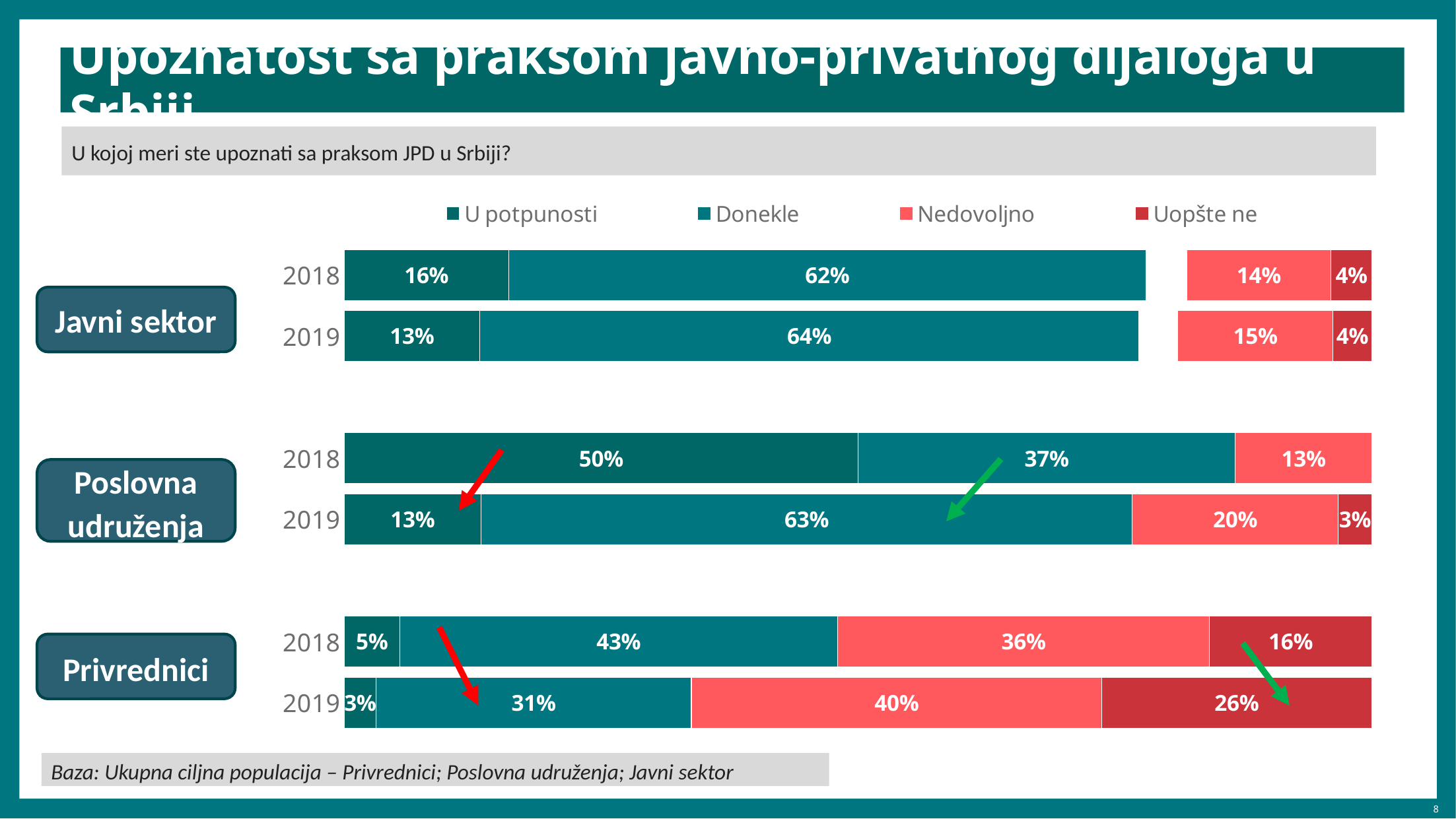
In the Poslovna udruženja chart, what is the value for Nedovoljno in 2019? 20% How many series does the legend list? 4 In the Javni sektor chart, what is the value for Donekle in 2018? 62% In the Javni sektor chart, what is the value for U potpunosti in 2019? 13% In the Privrednici chart, what is the value for Uopšte ne in 2019? 26% In the Poslovna udruženja chart, which series has the highest value in 2018? U potpunosti In the Privrednici chart, which series has the lowest value in 2019? U potpunosti What kind of chart is used on this slide? Stacked bar chart In the Privrednici chart, which is larger: Nedovoljno in 2018 or Nedovoljno in 2019? Nedovoljno in 2019 In the Javni sektor chart, how many years are shown? 2 In the Privrednici chart, what is the total of the stacked bar for 2018? 100% In the Poslovna udruženja chart, what is the difference between the U potpunosti values for 2018 and 2019? 37%